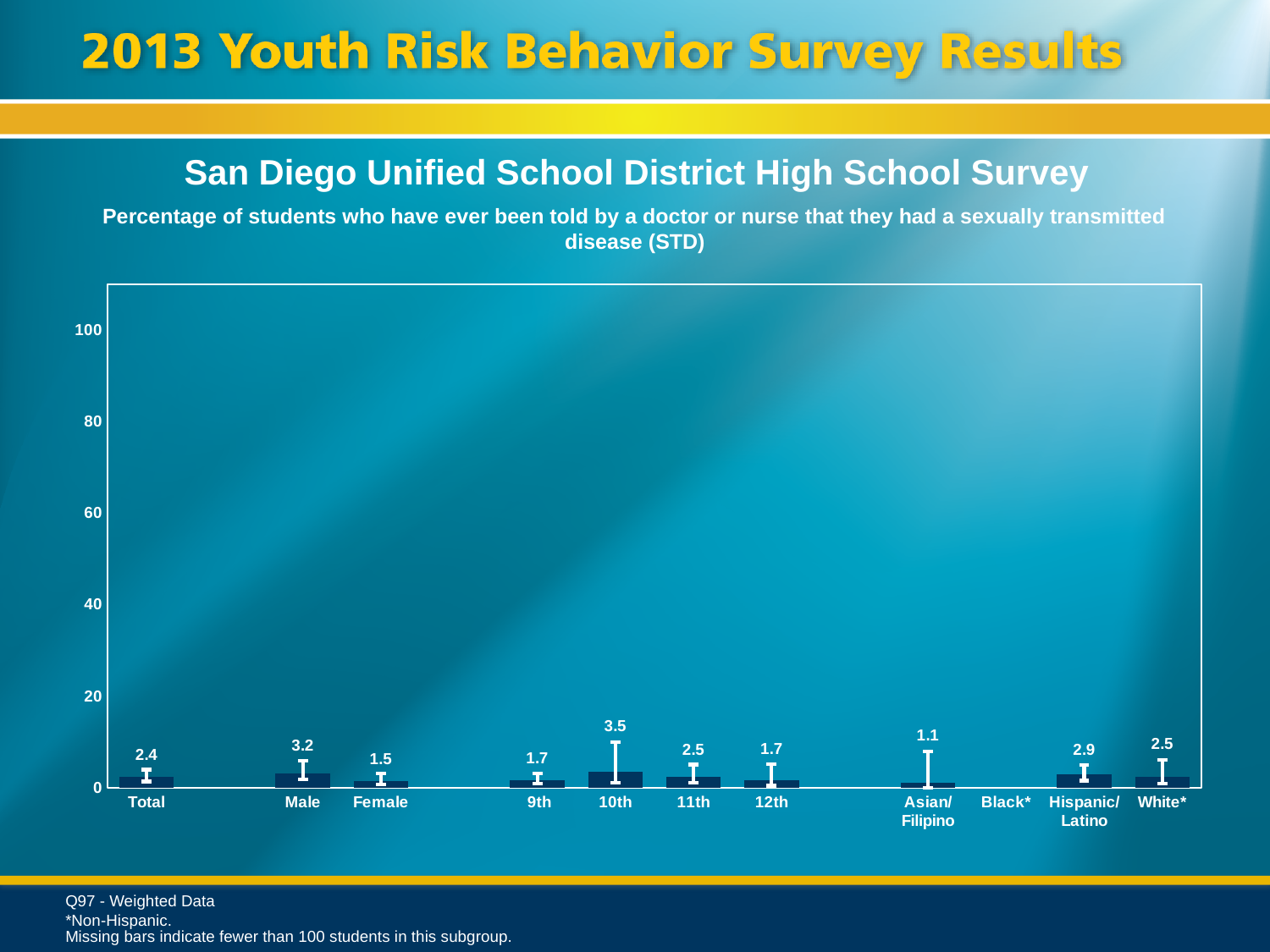
Which category has the highest value? 10th Which category has no bar plotted? Black* What is the value for Asian/Filipino? 1.1 What is the difference between the Male and Female values? 1.7 Which category with a plotted bar has the lowest value? Asian/Filipino Which is larger, the value for 11th grade or 12th grade? 11th Is the value for Hispanic/Latino greater or less than 20? less What kind of chart is shown? bar chart What is the value for Male? 3.2 How many categories are labeled on the x axis? 11 What is the value for Total? 2.4 What is the value for 10th grade? 3.5